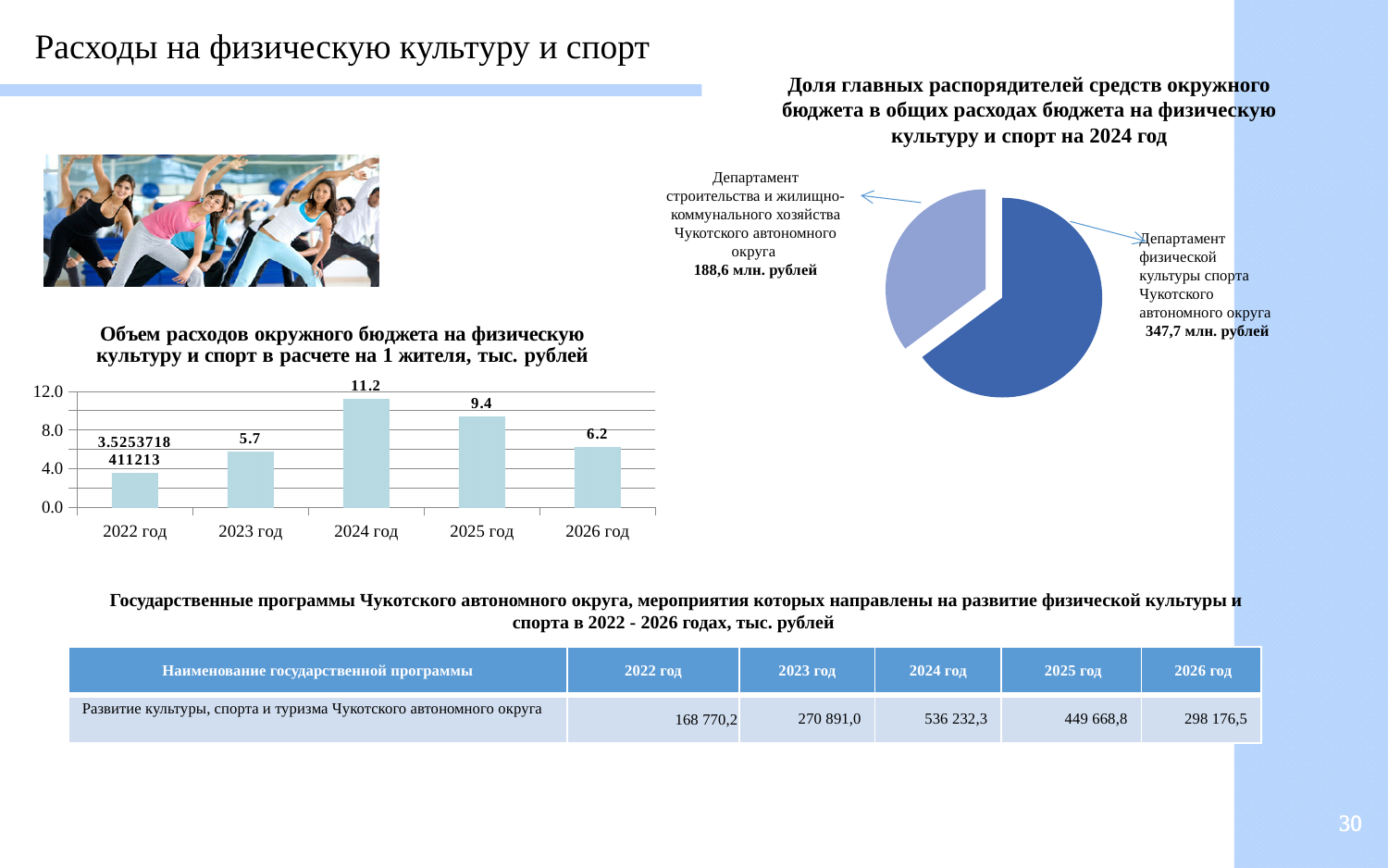
In the bar chart on the left, which is larger: the value for 2023 год or the value for 2026 год? 2026 год In the bar chart on the left, which year has the highest value? 2024 год In the bar chart on the left, which year has the lowest value? 2022 год In the pie chart on the right, what is the value for Департамент физической культуры спорта Чукотского автономного округа? 347,7 млн. рублей In the bar chart on the left, what is the value for 2026 год? 6.2 In the bar chart 'Объем расходов окружного бюджета на физическую культуру и спорт в расчете на 1 жителя', what is the value for 2024 год? 11.2 What kind of chart is the chart on the right titled 'Доля главных распорядителей средств окружного бюджета...'? pie chart In the pie chart on the right, what is the difference between the value for Департамент физической культуры спорта and the value for Департамент строительства и жилищно-коммунального хозяйства? 159,1 млн. рублей In the bar chart on the left, what is the value for 2025 год? 9.4 In the bar chart on the left, is the value for 2022 год greater or less than 4.0? less In the bar chart on the left, what is the difference between the values for 2024 год and 2025 год? 1.8 How many years are shown on the x axis of the bar chart on the left? 5